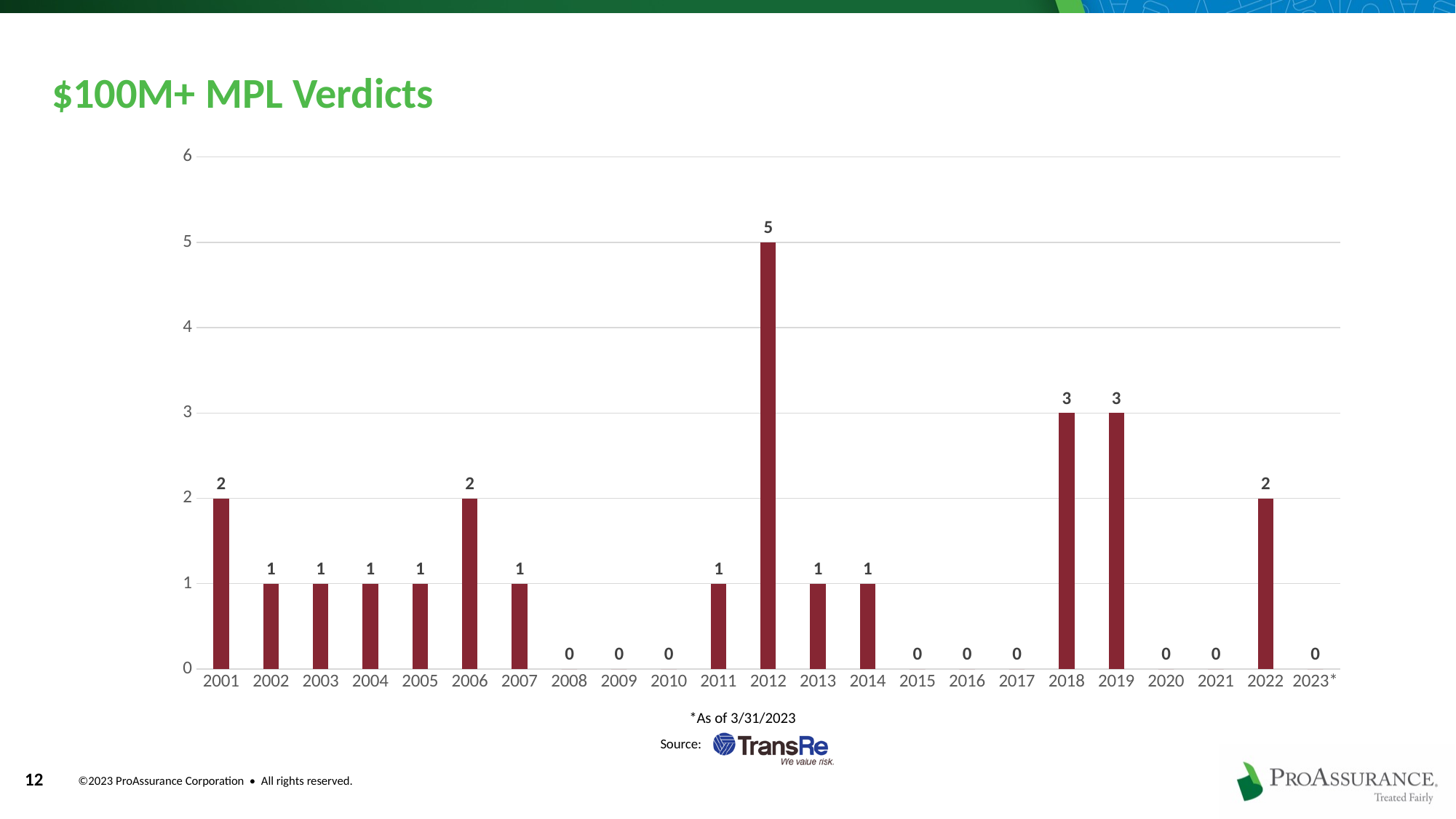
What kind of chart is this? Bar chart What is the value for 2018? 3 How many years have a value of 0? 9 What is the value for 2022? 2 How many years are shown on the x axis? 23 What is the value for 2015? 0 What is the value for 2012? 5 What is the source cited for the chart? TransRe What is the title of the chart? $100M+ MPL Verdicts What is the difference between the values for 2012 and 2019? 2 Which is larger, the value for 2006 or the value for 2007? 2006 Which year has the highest value? 2012